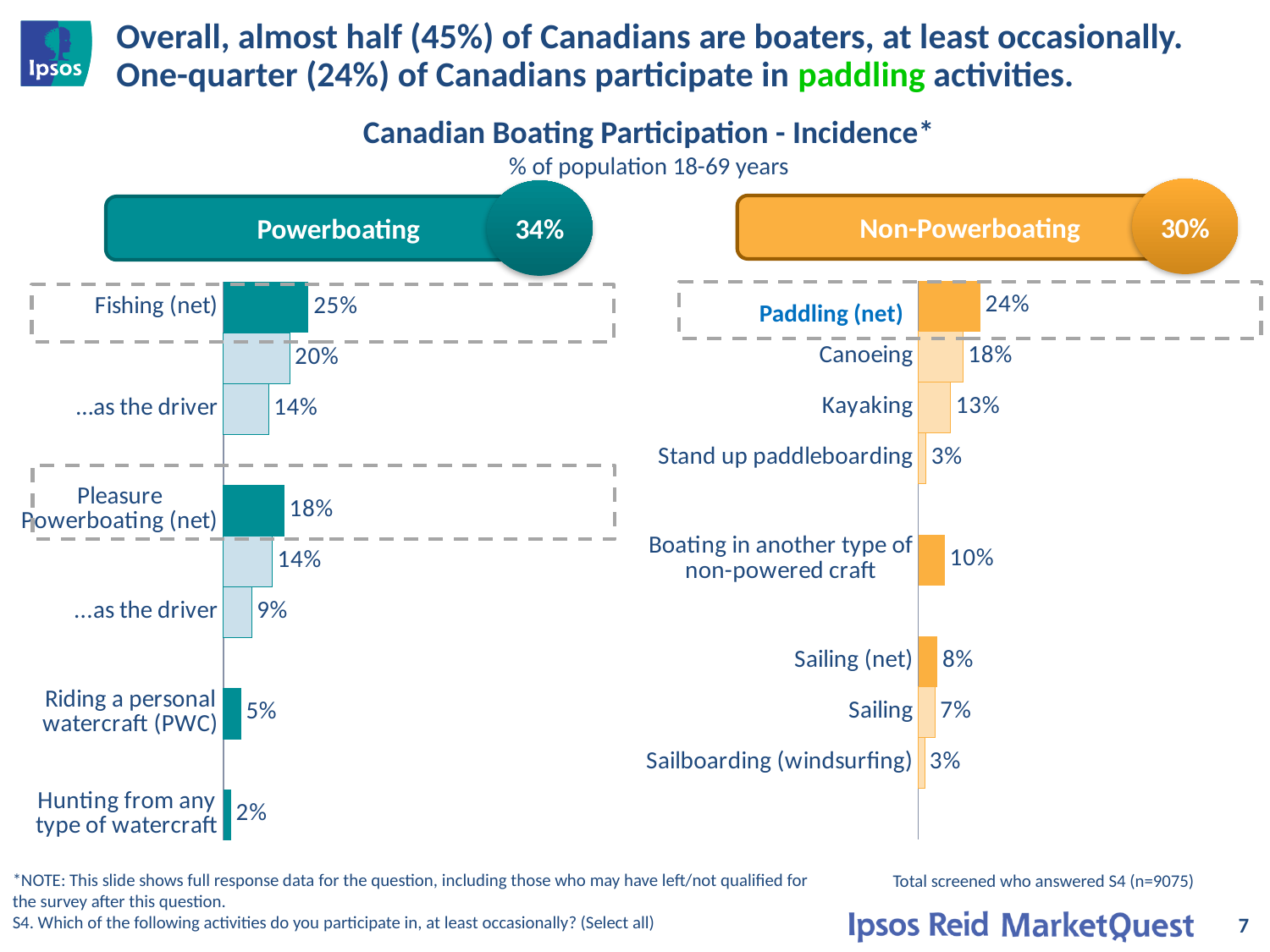
How many categories are shown in the Non-Powerboating chart? 8 In the Powerboating chart, what is the value for Pleasure Powerboating (net)? 18% Which is larger: Riding a personal watercraft (PWC) in the Powerboating chart or Sailing (net) in the Non-Powerboating chart? Sailing (net) In the Powerboating chart, what is the value for Fishing (net)? 25% In the Powerboating chart, what is the difference between Fishing (net) and Pleasure Powerboating (net)? 7% What overall incidence is shown in the circle next to the Powerboating heading? 34% In the Non-Powerboating chart, which category has the highest value? Paddling (net) What kind of chart is used for the Non-Powerboating data? Bar chart In the Non-Powerboating chart, what is the value for Boating in another type of non-powered craft? 10% In the Powerboating chart, which category has the lowest value? Hunting from any type of watercraft In the Non-Powerboating chart, what is the difference between Canoeing and Kayaking? 5% In the Non-Powerboating chart, what is the value for Kayaking? 13%